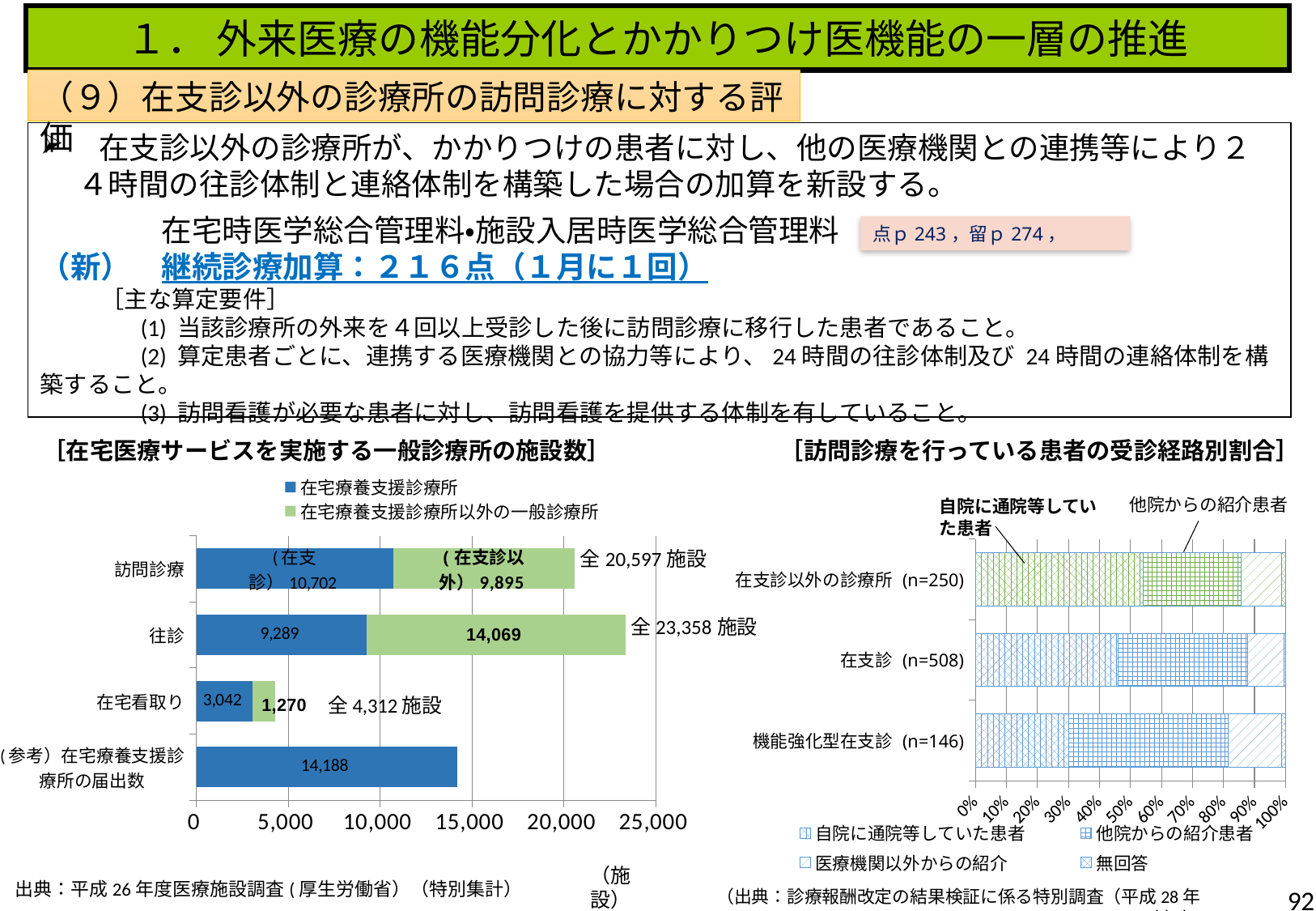
In the left chart [在宅医療サービスを実施する一般診療所の施設数], which category has the smallest total bar? 在宅看取り What kind of chart is the right chart [訪問診療を行っている患者の受診経路別割合]? Stacked bar chart In the left chart [在宅医療サービスを実施する一般診療所の施設数], what is the difference between the 在宅療養支援診療所 value and the 在宅療養支援診療所以外の一般診療所 value for 在宅看取り? 1,772 In the left chart [在宅医療サービスを実施する一般診療所の施設数], which category has the largest total bar? 往診 In the left chart [在宅医療サービスを実施する一般診療所の施設数], what is the value for 在宅療養支援診療所 in the 訪問診療 category? 10,702 In the left chart [在宅医療サービスを実施する一般診療所の施設数], what is the total number of facilities shown for 在宅看取り? 全 4,312 施設 In the left chart [在宅医療サービスを実施する一般診療所の施設数], what is the value for (参考) 在宅療養支援診療所の届出数? 14,188 How many series does the legend of the right chart [訪問診療を行っている患者の受診経路別割合] list? 4 In the left chart [在宅医療サービスを実施する一般診療所の施設数], which is larger for 訪問診療: the 在宅療養支援診療所 value or the 在宅療養支援診療所以外の一般診療所 value? 在宅療養支援診療所 In the left chart [在宅医療サービスを実施する一般診療所の施設数], what is the value for 在宅療養支援診療所以外の一般診療所 in the 往診 category? 14,069 In the left chart [在宅医療サービスを実施する一般診療所の施設数], what is the total number of facilities shown for 往診? 全 23,358 施設